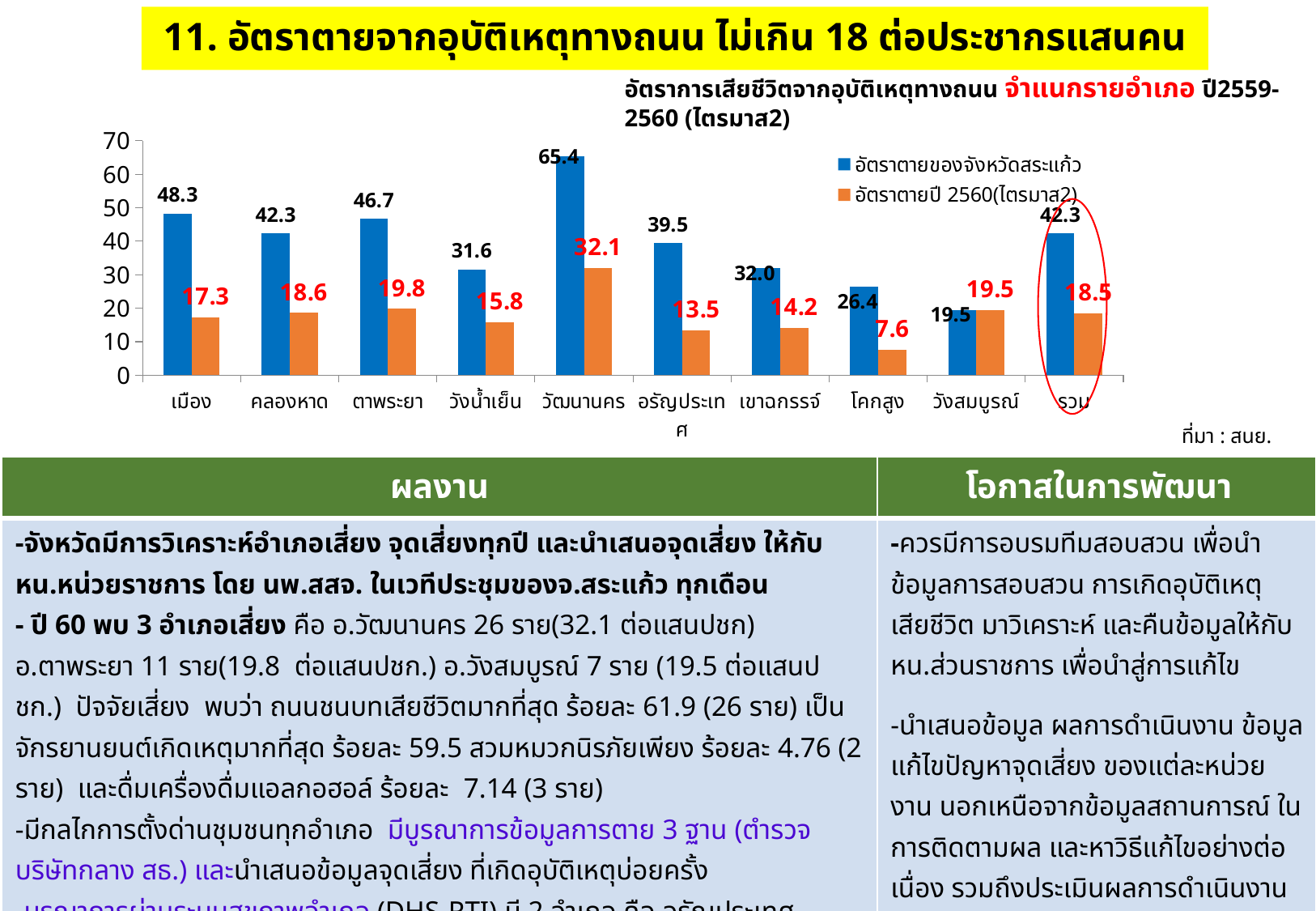
Which category has the highest value in the blue series (อัตราตายของจังหวัดสระแก้ว)? วัฒนานคร How many categories are shown on the x axis? 10 What is the value of the orange series (อัตราตายปี 2560(ไตรมาส2)) for โคกสูง? 7.6 What kind of chart is shown on the slide? Bar chart How many series does the legend list? 2 What is the value of the blue series (อัตราตายของจังหวัดสระแก้ว) for วัฒนานคร? 65.4 Is the blue series value for โคกสูง greater or less than 30? less Which category has the lowest value in the orange series (อัตราตายปี 2560(ไตรมาส2))? โคกสูง Which is larger for วังสมบูรณ์: the blue series value or the orange series value? They are equal (19.5) What is the value of the orange series (อัตราตายปี 2560(ไตรมาส2)) for รวม? 18.5 What is the value of the orange series (อัตราตายปี 2560(ไตรมาส2)) for ตาพระยา? 19.8 What is the difference between the blue and orange values for เมือง? 31.0